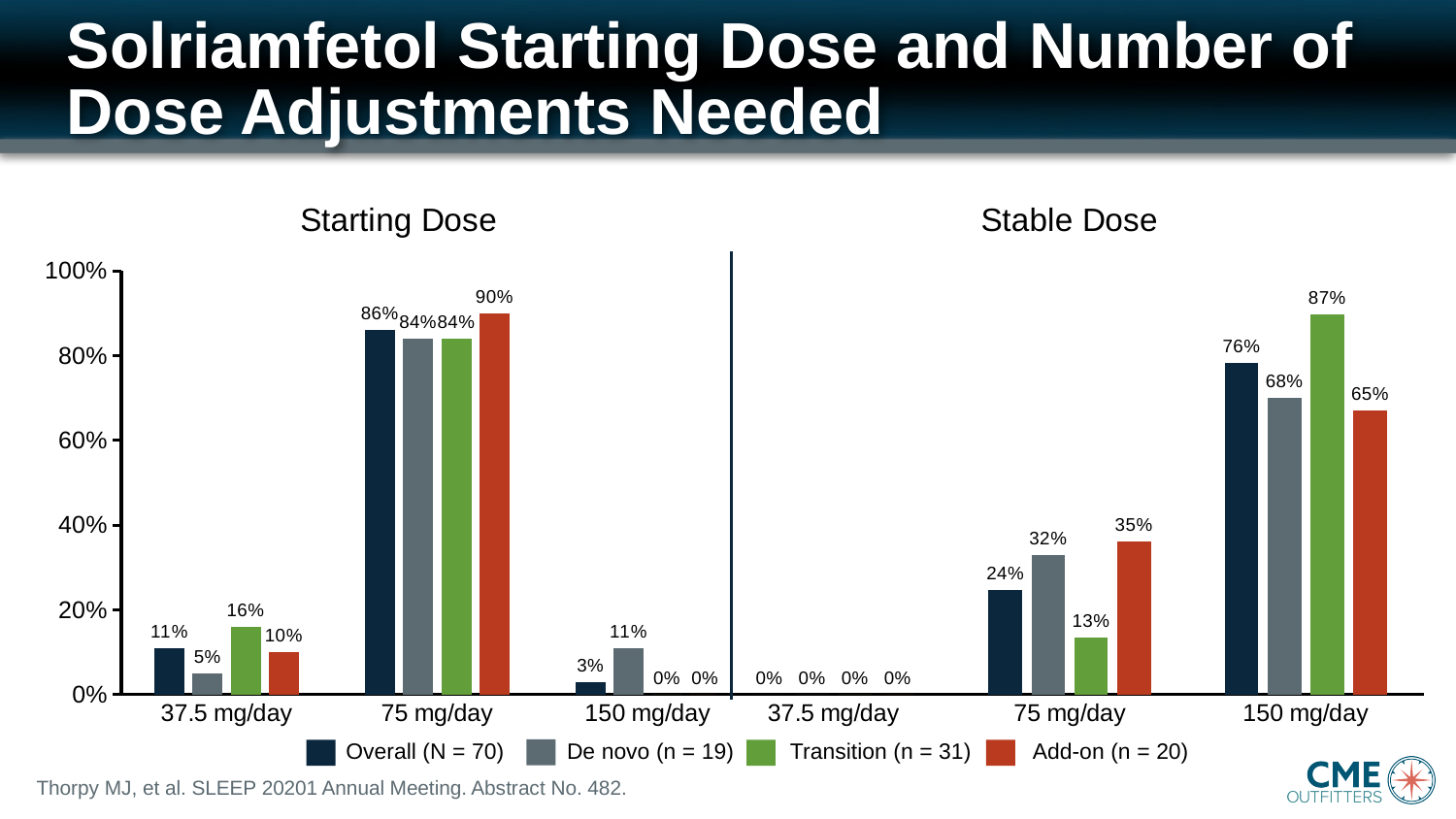
Which group has the highest value for the 75 mg/day starting dose? Add-on (n = 20) What kind of chart is shown on the slide? Bar chart How many series does the legend list? 4 What are the two section headings above the chart? Starting Dose and Stable Dose What is the Overall (N = 70) value for the 75 mg/day starting dose? 86% What is the De novo (n = 19) value for the 75 mg/day stable dose? 32% What is the Add-on (n = 20) value for the 37.5 mg/day starting dose? 10% Which group has the lowest value for the 75 mg/day stable dose? Transition (n = 31) What is the Transition (n = 31) value for the 150 mg/day stable dose? 87% How many dose categories are shown on the x axis? 6 What is the difference between the Overall and Add-on values for the 150 mg/day stable dose? 11% For the 37.5 mg/day starting dose, which is larger: the Overall value or the De novo value? Overall